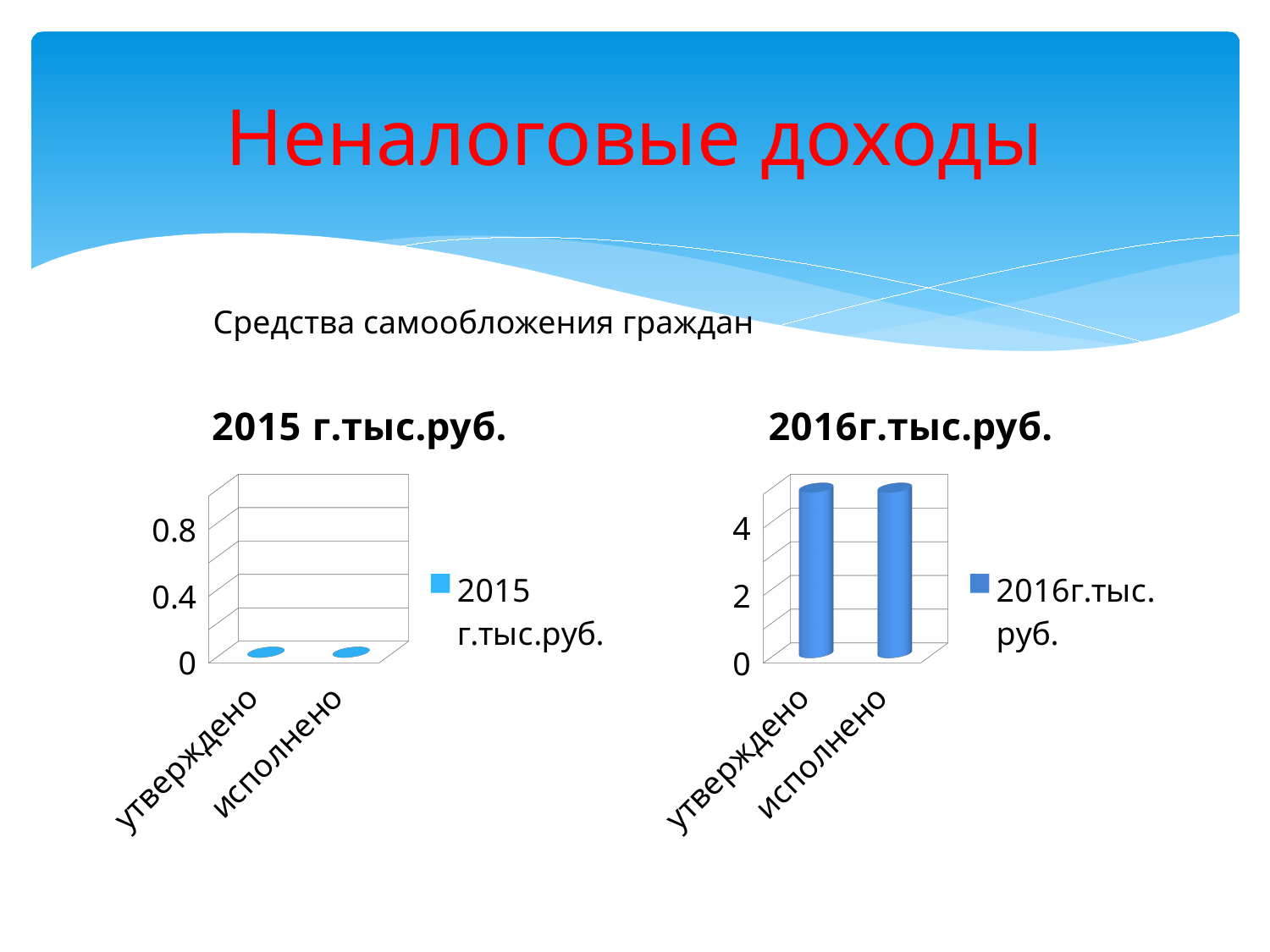
What are the two category labels on the x axis of the "2016г.тыс.руб." chart? утверждено, исполнено How many series does the legend of the "2016г.тыс.руб." chart list? 1 In the "2015 г.тыс.руб." chart, what value does the bar for исполнено show? 0 In the "2016г.тыс.руб." chart, is the value for утверждено greater or less than 4? greater What kind of chart is the "2015 г.тыс.руб." chart? bar chart What is the legend entry of the "2015 г.тыс.руб." chart? 2015 г.тыс.руб. How many categories are shown on the x axis of the "2015 г.тыс.руб." chart? 2 What is the title of the chart on the right side of the slide? 2016г.тыс.руб. What kind of chart is the "2016г.тыс.руб." chart? bar chart In the "2016г.тыс.руб." chart, is the value for исполнено greater or less than 2? greater In the "2015 г.тыс.руб." chart, is the value for утверждено greater or less than 0.4? less How many categories are shown on the x axis of the "2016г.тыс.руб." chart? 2